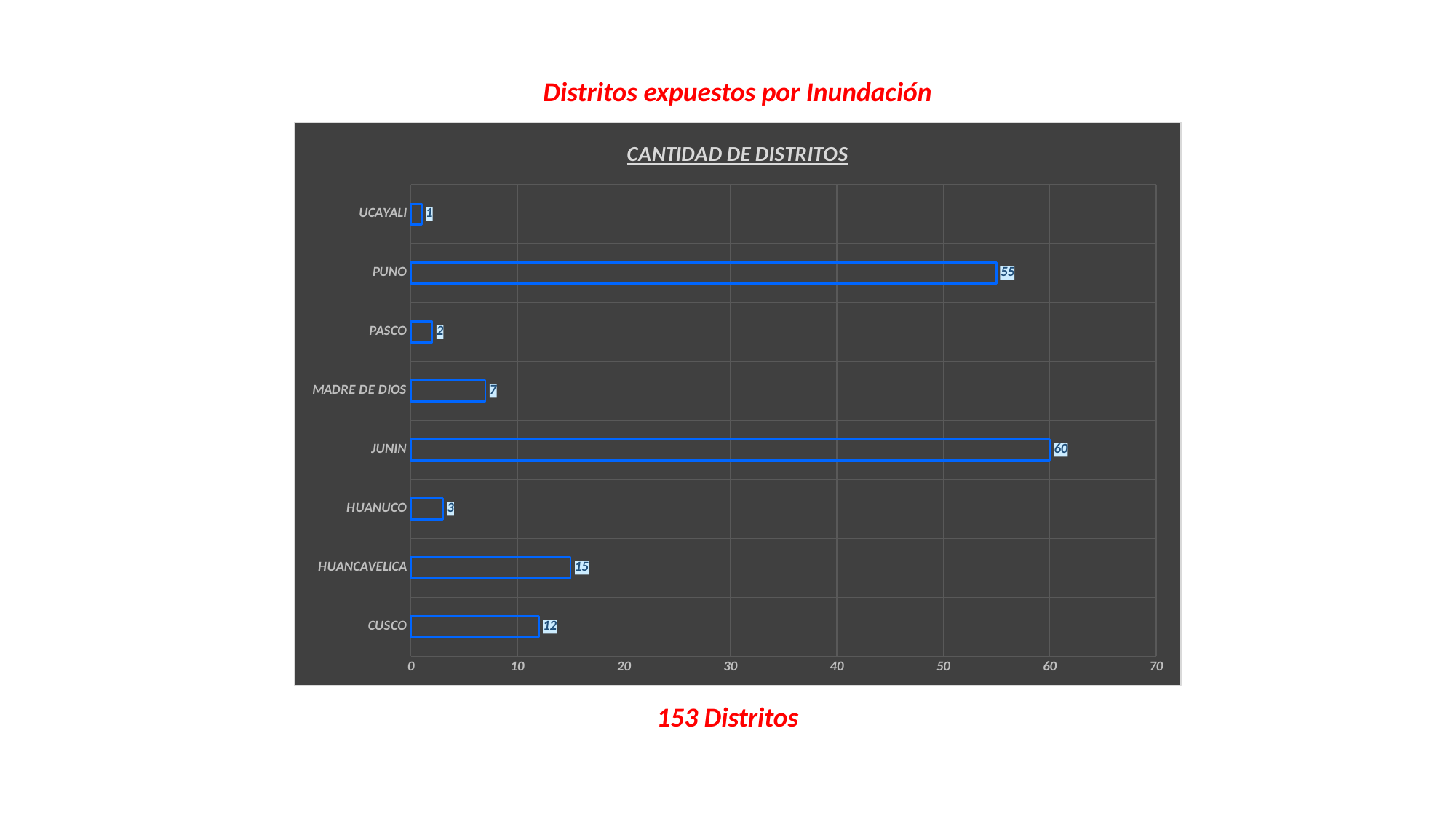
What is the difference between the values for HUANCAVELICA and CUSCO? 3 Which is larger, the value for CUSCO or the value for HUANCAVELICA? HUANCAVELICA What kind of chart is shown? bar chart What is the difference between the values for JUNIN and PUNO? 5 What is the value for JUNIN? 60 What is the title of the chart? CANTIDAD DE DISTRITOS Is the value for PUNO greater or less than 50? greater How many categories are shown on the chart? 8 Which category has the highest value? JUNIN What is the value for MADRE DE DIOS? 7 Which category has the lowest value? UCAYALI What is the value for HUANCAVELICA? 15